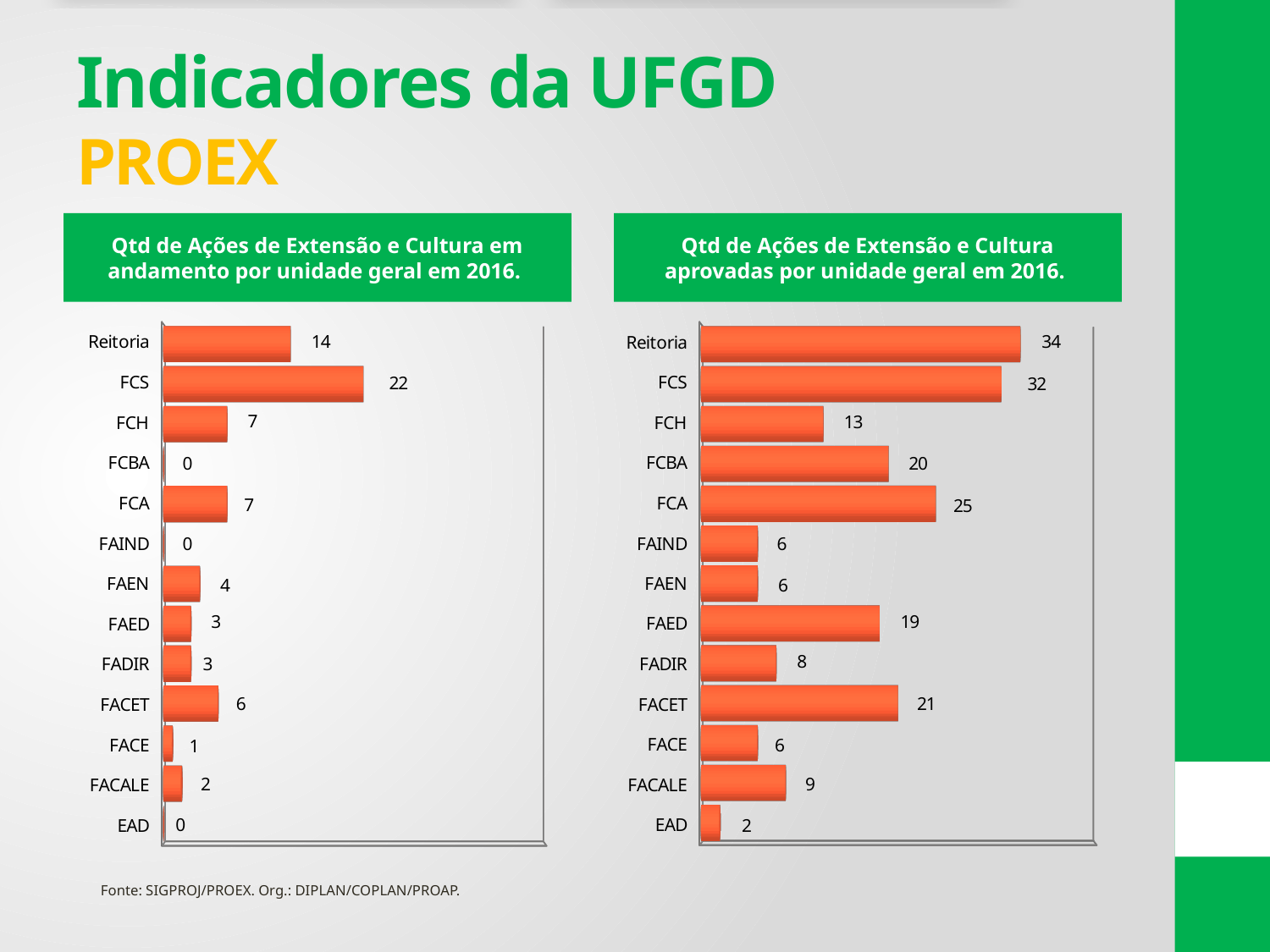
In the left chart (ações em andamento), what is the difference between FCS and Reitoria? 8 In the left chart (ações em andamento), what is the value for FACALE? 2 How many units are listed in the right chart (ações aprovadas)? 13 In the right chart (ações aprovadas), what is the difference between Reitoria and FCS? 2 In the right chart (ações aprovadas), which is larger, FACET or FCBA? FACET In the left chart (ações em andamento), which is larger, FACET or FAEN? FACET In the left chart (ações em andamento), what is the value for FCS? 22 In the right chart (ações aprovadas), which unit has the lowest value? EAD In the left chart (ações em andamento), which unit has the highest value? FCS In the right chart (ações aprovadas), which unit has the highest value? Reitoria In the right chart (ações aprovadas), what is the value for FCA? 25 What kind of chart is the left chart (ações em andamento)? Bar chart